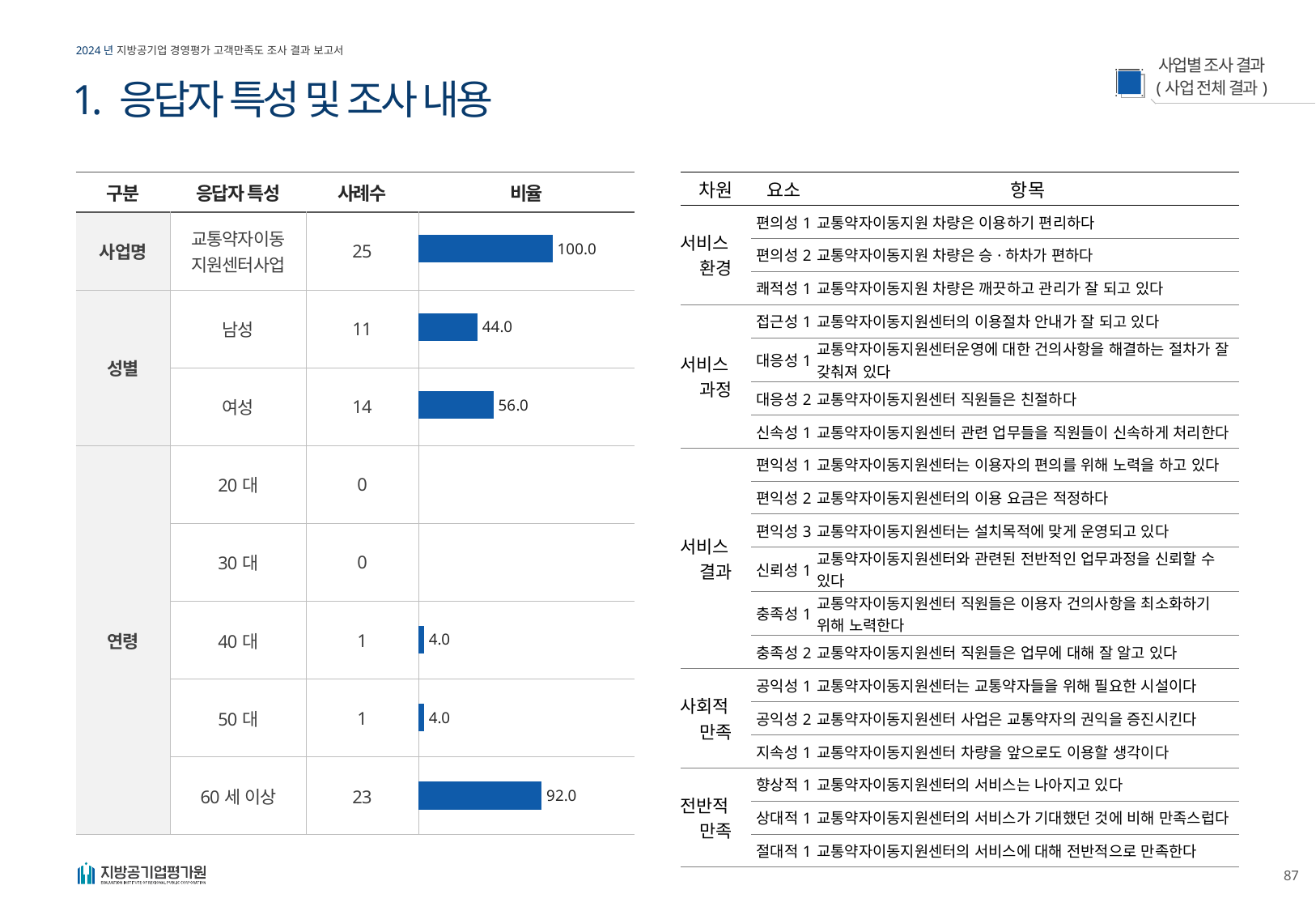
How many 연령 categories are listed in the table? 6 Which 연령 category has the highest 비율? 60 세 이상 Which has a larger 비율, 50 대 or 60 세 이상? 60 세 이상 What is the 비율 value shown for 남성? 44.0 What is the 비율 value shown for 60 세 이상? 92.0 What is the 사례수 for 여성? 14 What kind of chart is used in the 비율 column? bar chart Which 성별 category has the lower 비율? 남성 What is the difference between the 비율 for 여성 and 남성? 12.0 What is the 비율 value shown for 여성? 56.0 What is the difference between the 비율 for 60 세 이상 and 40 대? 88.0 What is the 비율 value shown for 40 대? 4.0